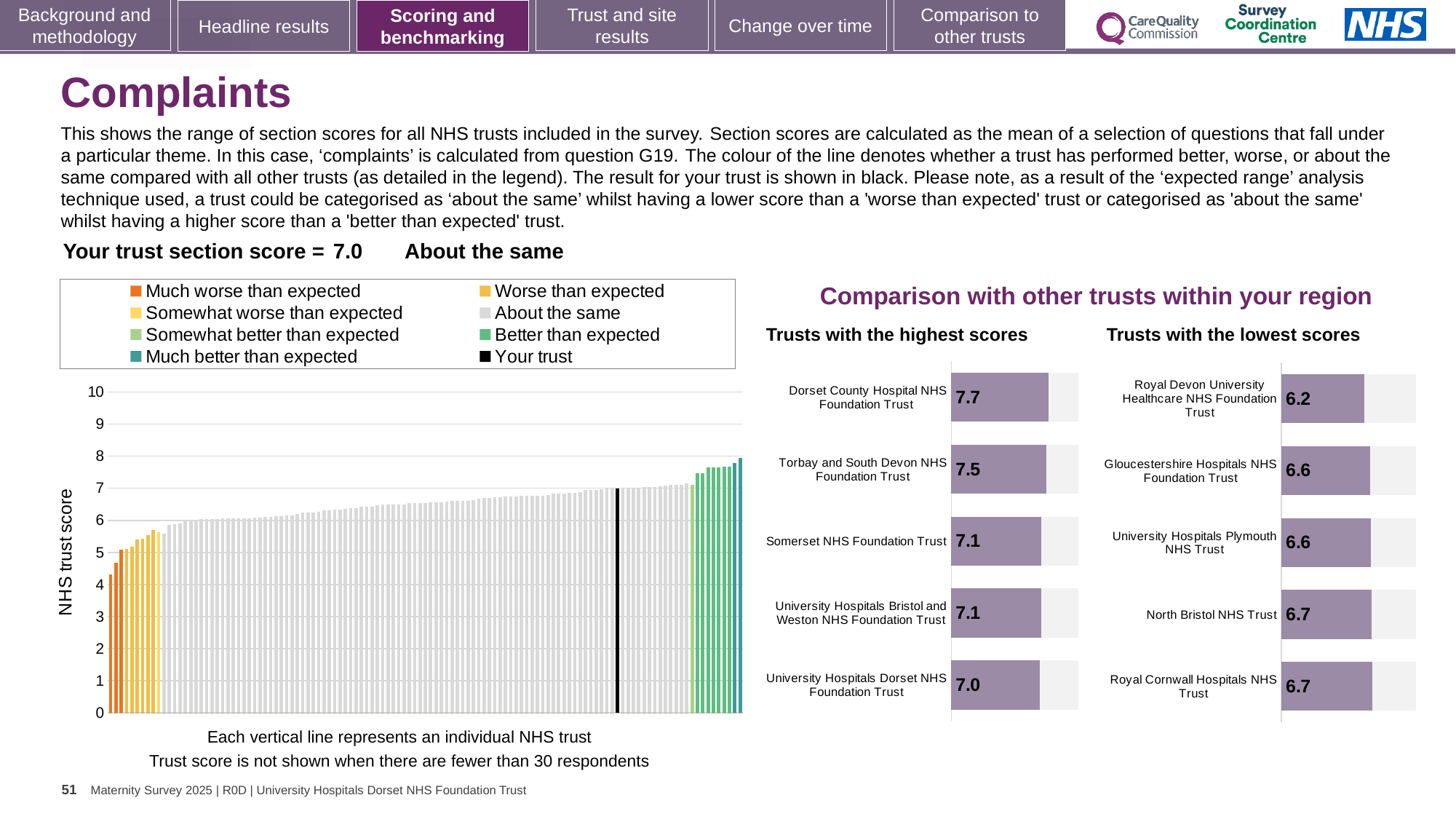
How many trusts are shown in the 'Trusts with the highest scores' chart? 5 In the 'Trusts with the highest scores' chart, what is the score for Torbay and South Devon NHS Foundation Trust? 7.5 In the 'Trusts with the highest scores' chart, what is the score for Dorset County Hospital NHS Foundation Trust? 7.7 In the NHS trust score chart on the left, do the values rise or fall from left to right? rise In the 'Trusts with the lowest scores' chart, what is the score for Royal Devon University Healthcare NHS Foundation Trust? 6.2 How many entries does the legend of the NHS trust score chart on the left list? 8 In the NHS trust score chart on the left, is the value of the lowest bar greater or less than 5? less In the 'Trusts with the lowest scores' chart, which trust has the lowest score? Royal Devon University Healthcare NHS Foundation Trust In the 'Trusts with the lowest scores' chart, what is the score for North Bristol NHS Trust? 6.7 In the 'Trusts with the lowest scores' chart, which has the larger score: Gloucestershire Hospitals NHS Foundation Trust or Royal Cornwall Hospitals NHS Trust? Royal Cornwall Hospitals NHS Trust In the 'Trusts with the highest scores' chart, what is the difference between the scores of Dorset County Hospital NHS Foundation Trust and University Hospitals Dorset NHS Foundation Trust? 0.7 In the 'Trusts with the highest scores' chart, which trust has the highest score? Dorset County Hospital NHS Foundation Trust